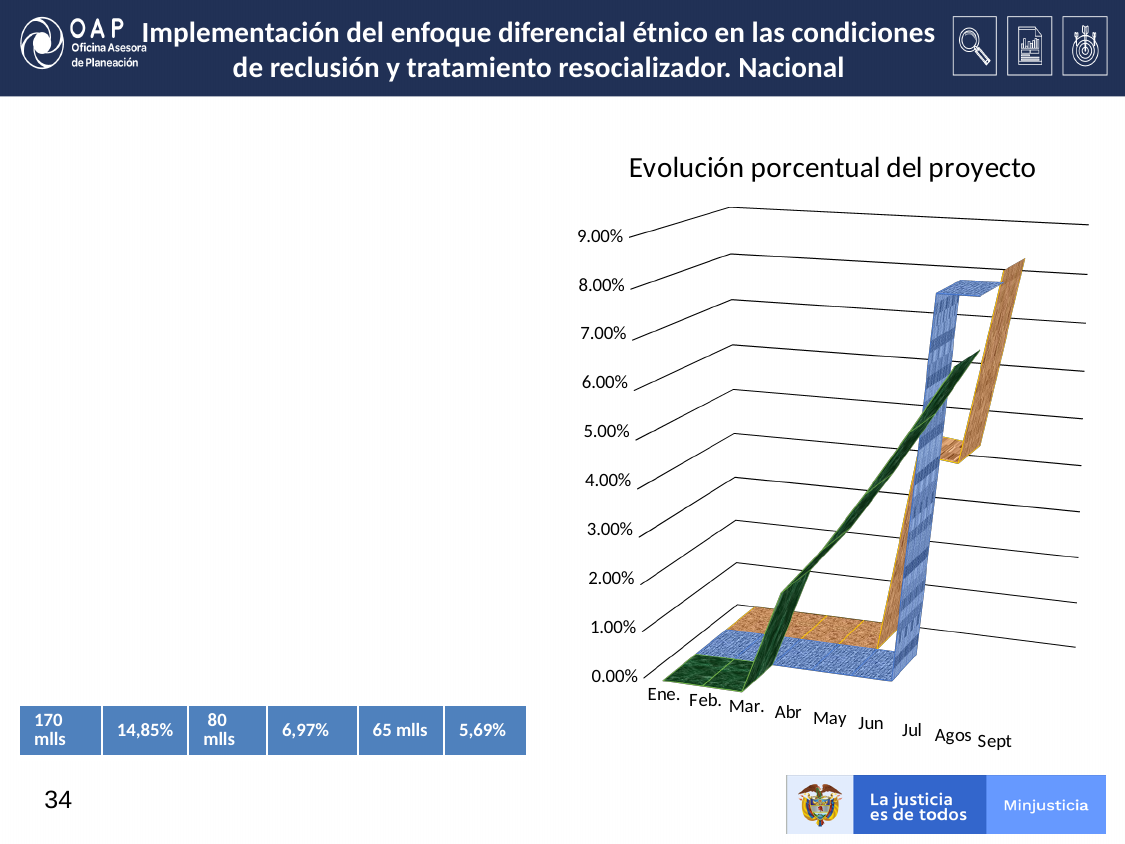
Does the green series rise or fall from Ene. to Jul? rise Is the value of the orange series at Jun greater or less than 3.00%? greater What is the highest value shown on the y axis of the chart? 9.00% What is the title of the chart on the slide? Evolución porcentual del proyecto What kind of chart is shown on the slide? line chart Is the value of the blue series at Mar. greater or less than 2.00%? less How many months are shown on the x axis of the chart? 9 What is the first category on the x axis of the chart? Ene. Is the value of the blue series at Agos greater or less than 5.00%? greater